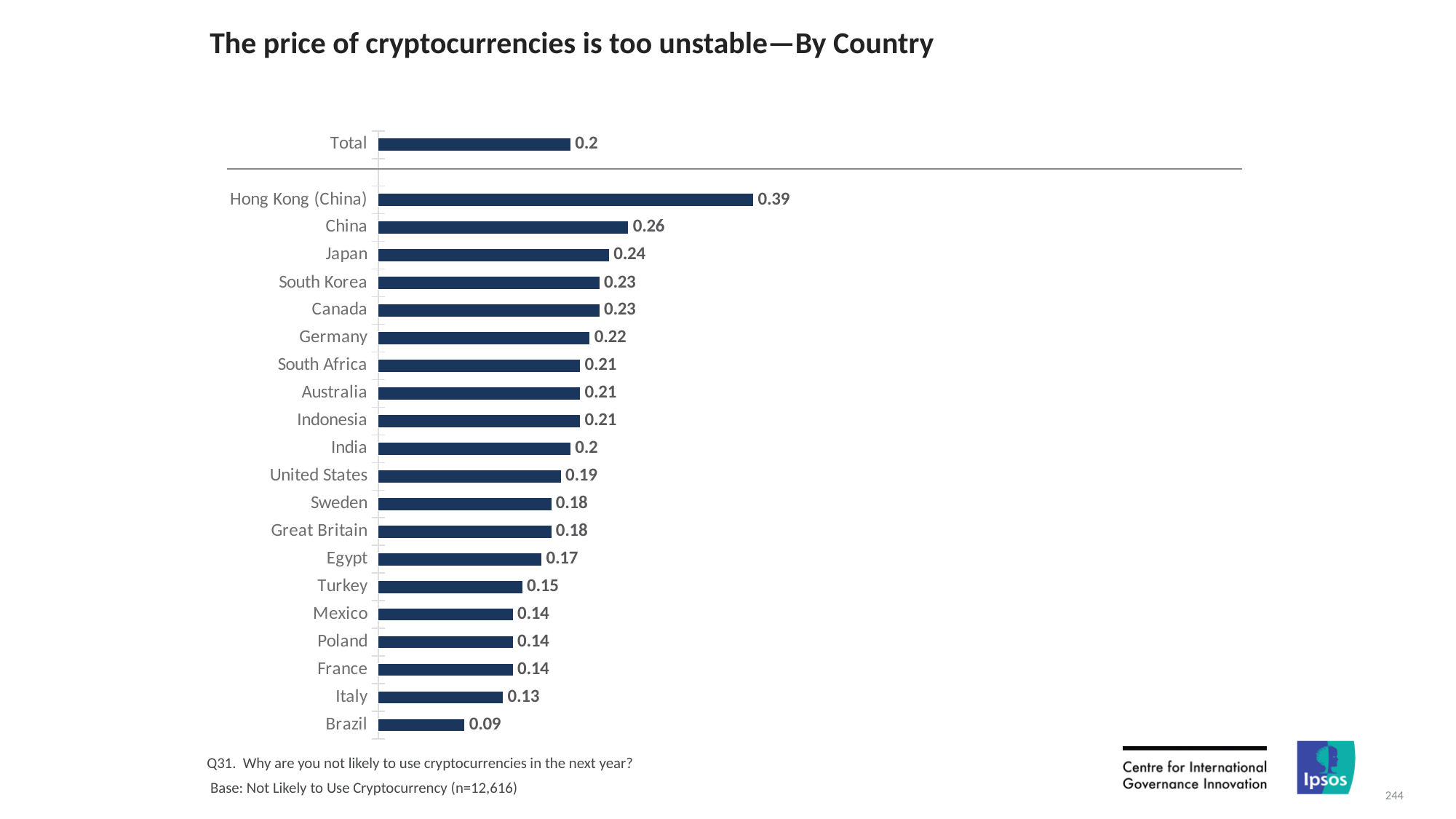
Which country has the highest value? Hong Kong (China) What is the value for the Total bar? 0.2 What is the difference between the values for Hong Kong (China) and China? 0.13 What kind of chart is shown on the slide? Bar chart Which has a larger value, Turkey or Egypt? Egypt What is the value for Brazil? 0.09 How many countries are listed below the Total bar? 20 What is the value for Germany? 0.22 What is the title of the chart? The price of cryptocurrencies is too unstable—By Country Which country has the lowest value? Brazil What is the value for Hong Kong (China)? 0.39 What is the difference between the values for Japan and Italy? 0.11